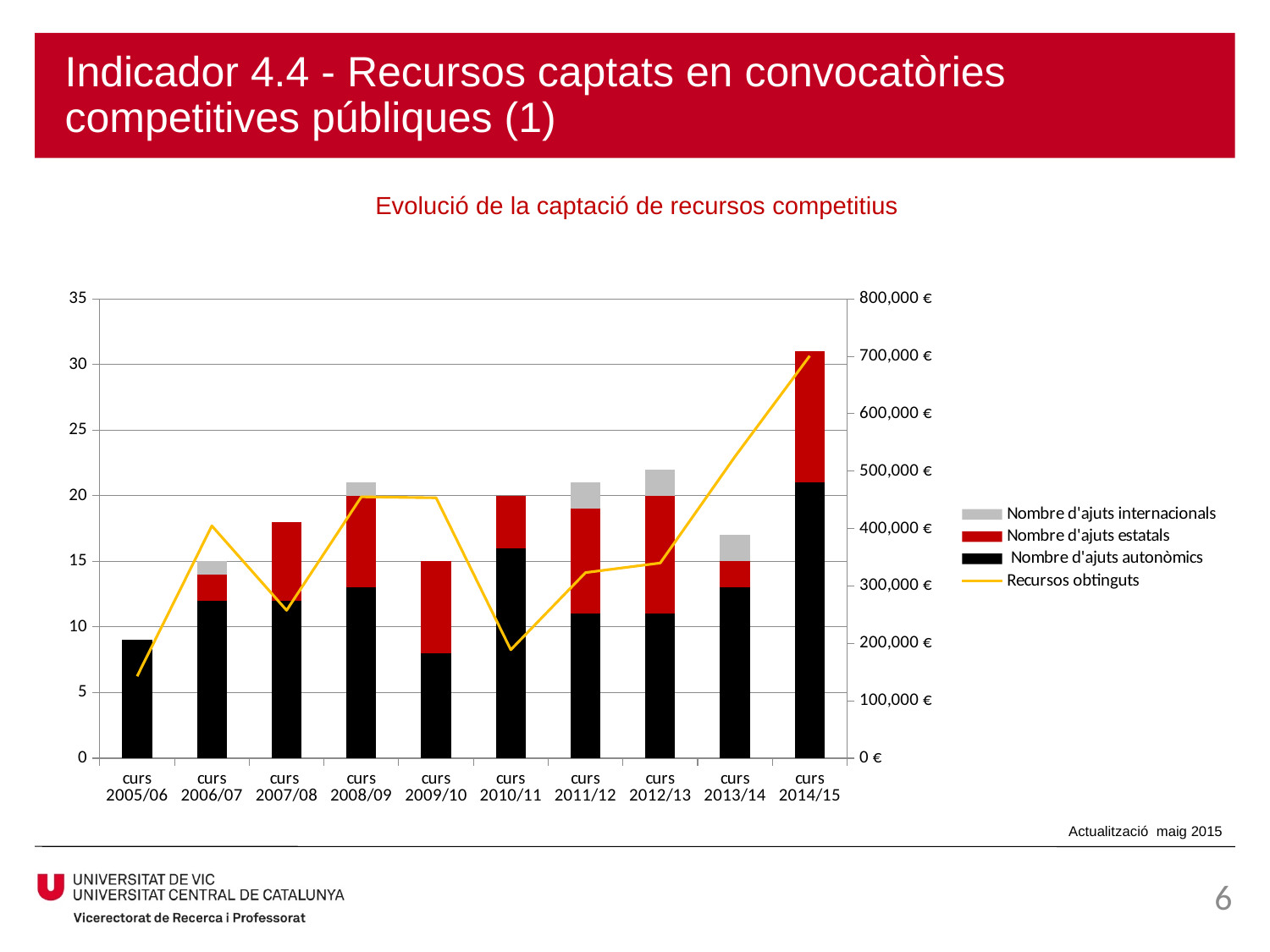
Is the value of Recursos obtinguts for curs 2014/15 greater or less than 600,000 €? greater Which year has a higher value of Recursos obtinguts, curs 2012/13 or curs 2013/14? curs 2013/14 Which academic year has the shortest stacked bar? curs 2005/06 Does the Recursos obtinguts line rise or fall from curs 2010/11 to curs 2014/15? rise Is the Nombre d'ajuts autonòmics segment for curs 2010/11 greater or less than 15? greater What colour represents Nombre d'ajuts estatals in the chart? Red What kind of chart is shown on the slide? Stacked bar chart with a line How many academic years (curs) are shown on the x axis? 10 Which academic year has the tallest stacked bar? curs 2014/15 Is the total height of the stacked bar for curs 2014/15 greater or less than 30? greater How many series does the legend list? 4